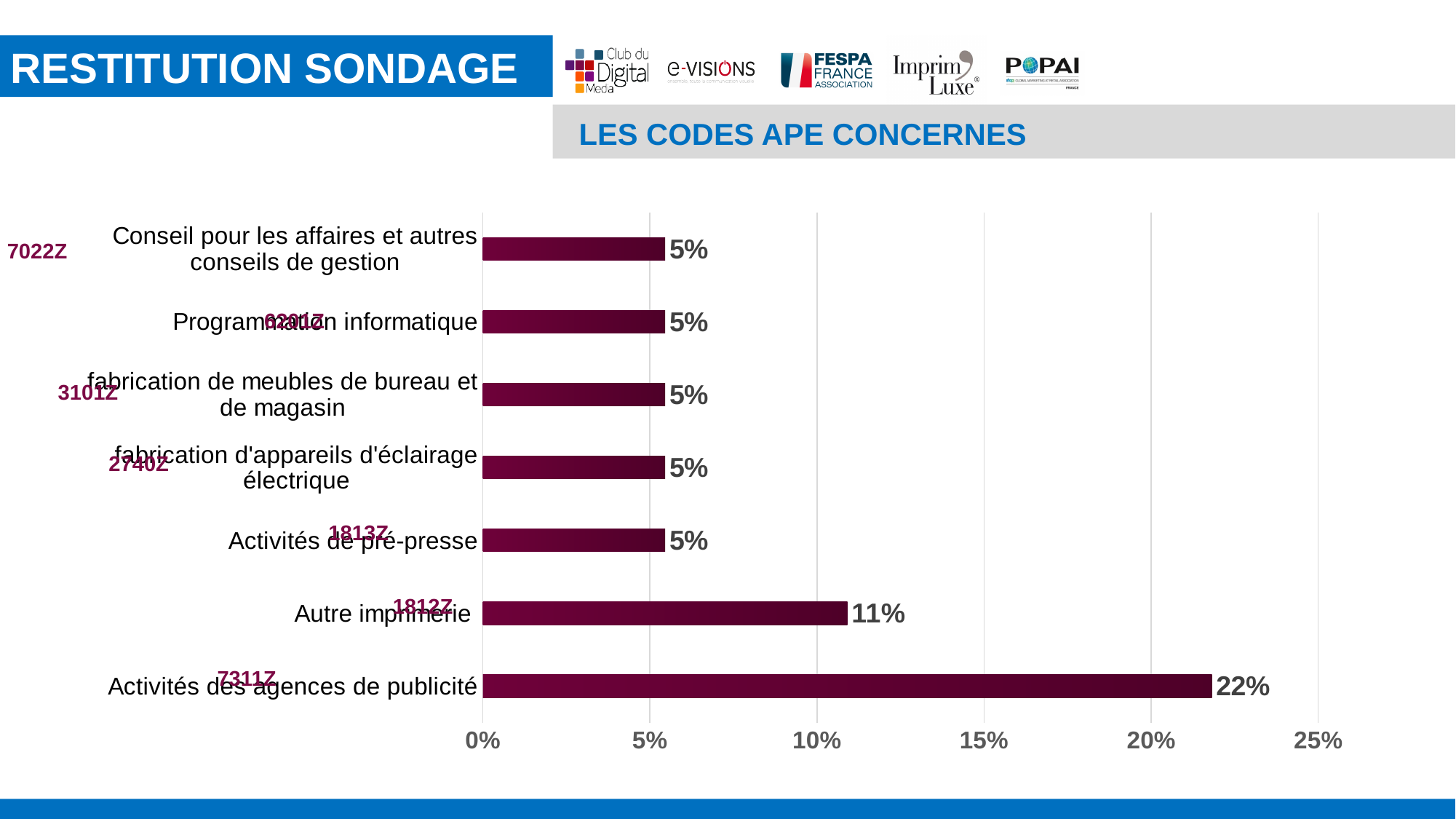
How many categories are shown in the chart? 7 Which is larger, the value for Autre imprimerie or the value for Activités de pré-presse? Autre imprimerie What is the value for Activités des agences de publicité? 22% What kind of chart is shown on the slide? bar chart Is the value for Activités des agences de publicité greater or less than 20%? greater What is the value for Activités de pré-presse? 5% What is the value for Programmation informatique? 5% What is the title shown above the chart? LES CODES APE CONCERNES What is the value for Autre imprimerie? 11% Which category has the highest value? Activités des agences de publicité Is the value for Autre imprimerie greater or less than 15%? less What is the difference between the values for Activités des agences de publicité and Autre imprimerie? 11%